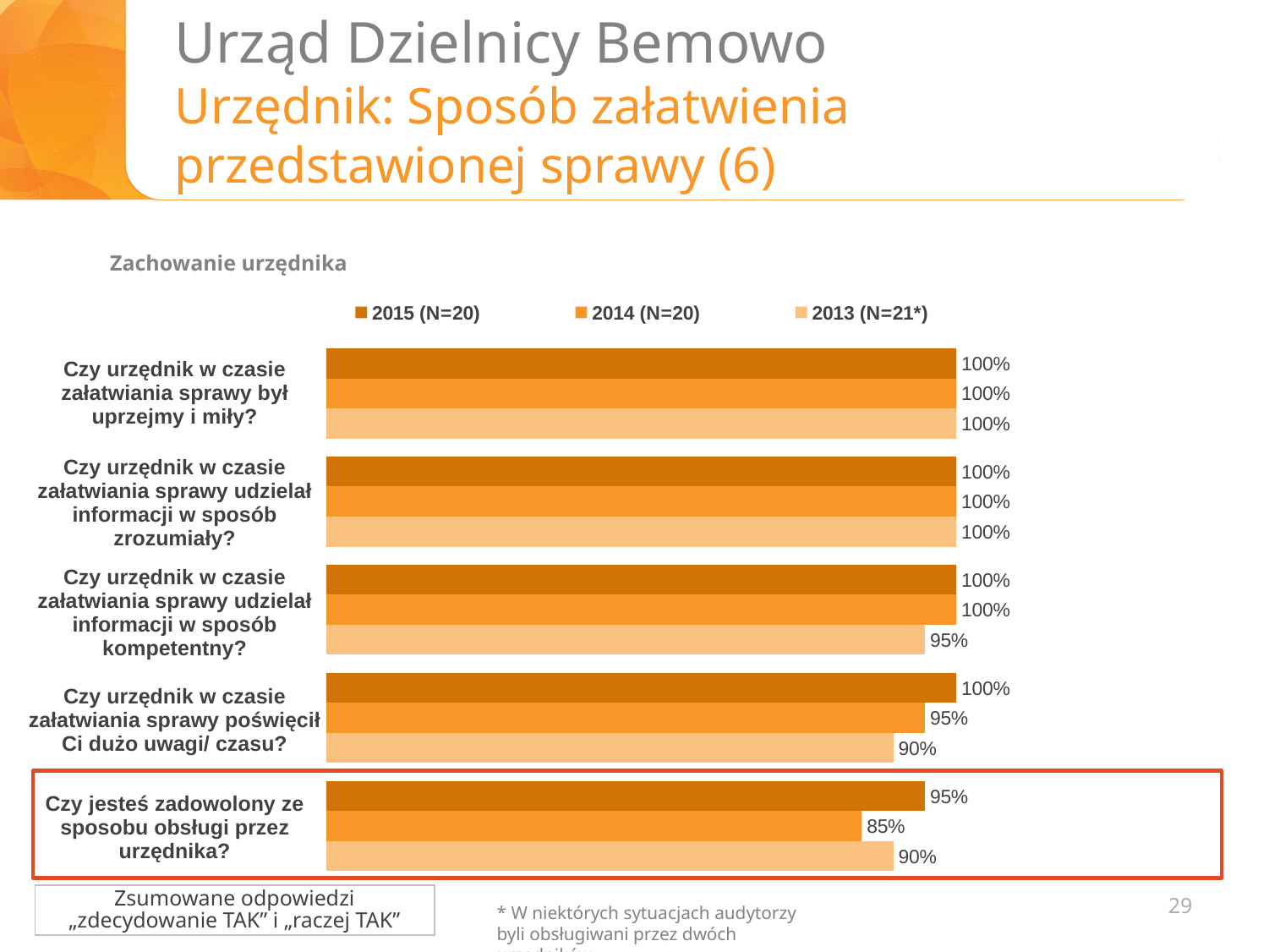
What is the difference between the 2015 and 2014 values for "Czy jesteś zadowolony ze sposobu obsługi przez urzędnika?"? 10% What is the 2013 value for "Czy urzędnik w czasie załatwiania sprawy poświęcił Ci dużo uwagi/ czasu?"? 90% For "Czy urzędnik w czasie załatwiania sprawy poświęcił Ci dużo uwagi/ czasu?", which is larger: the 2014 value or the 2013 value? 2014 (N=20) What type of chart is shown on the slide? bar chart What is the 2014 value for "Czy jesteś zadowolony ze sposobu obsługi przez urzędnika?"? 85% What is the sample size shown in the legend for 2013? N=21* Which year has the lowest value for "Czy jesteś zadowolony ze sposobu obsługi przez urzędnika?"? 2014 (N=20) How many series does the legend list? 3 What is the 2013 value for "Czy urzędnik w czasie załatwiania sprawy udzielał informacji w sposób kompetentny?"? 95% How many question categories are plotted on the chart? 5 What is the title of the chart? Zachowanie urzędnika What is the 2015 value for "Czy jesteś zadowolony ze sposobu obsługi przez urzędnika?"? 95%